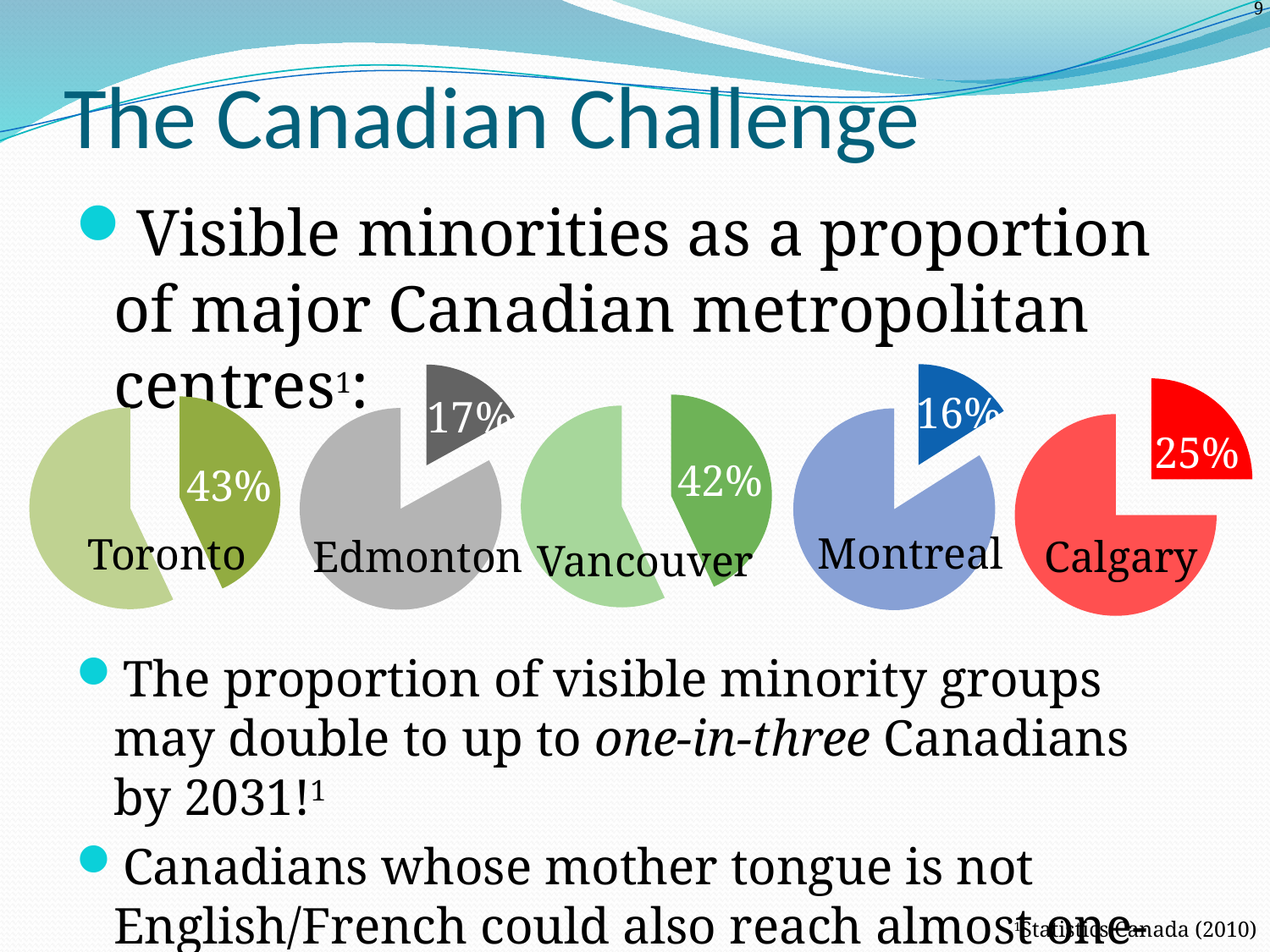
Comparing the Edmonton and Calgary pie charts, which city has the larger visible minority proportion? Calgary How many pie charts are shown on the slide? 5 In the Toronto pie chart, what percentage is shown for the visible minority slice? 43% In the Calgary pie chart, what percentage is shown for the visible minority slice? 25% What colour is the Calgary pie chart? Red In the Montreal pie chart, what percentage is shown for the visible minority slice? 16% What kind of chart is used to show the visible minority proportion for each city? Pie chart In the Vancouver pie chart, what percentage is shown for the visible minority slice? 42% Across the five pie charts, which city has the lowest visible minority proportion? Montreal What is the difference in percentage points between the Toronto pie chart value and the Calgary pie chart value? 18 Across the five pie charts, which city has the highest visible minority proportion? Toronto In the Edmonton pie chart, what percentage is shown for the visible minority slice? 17%